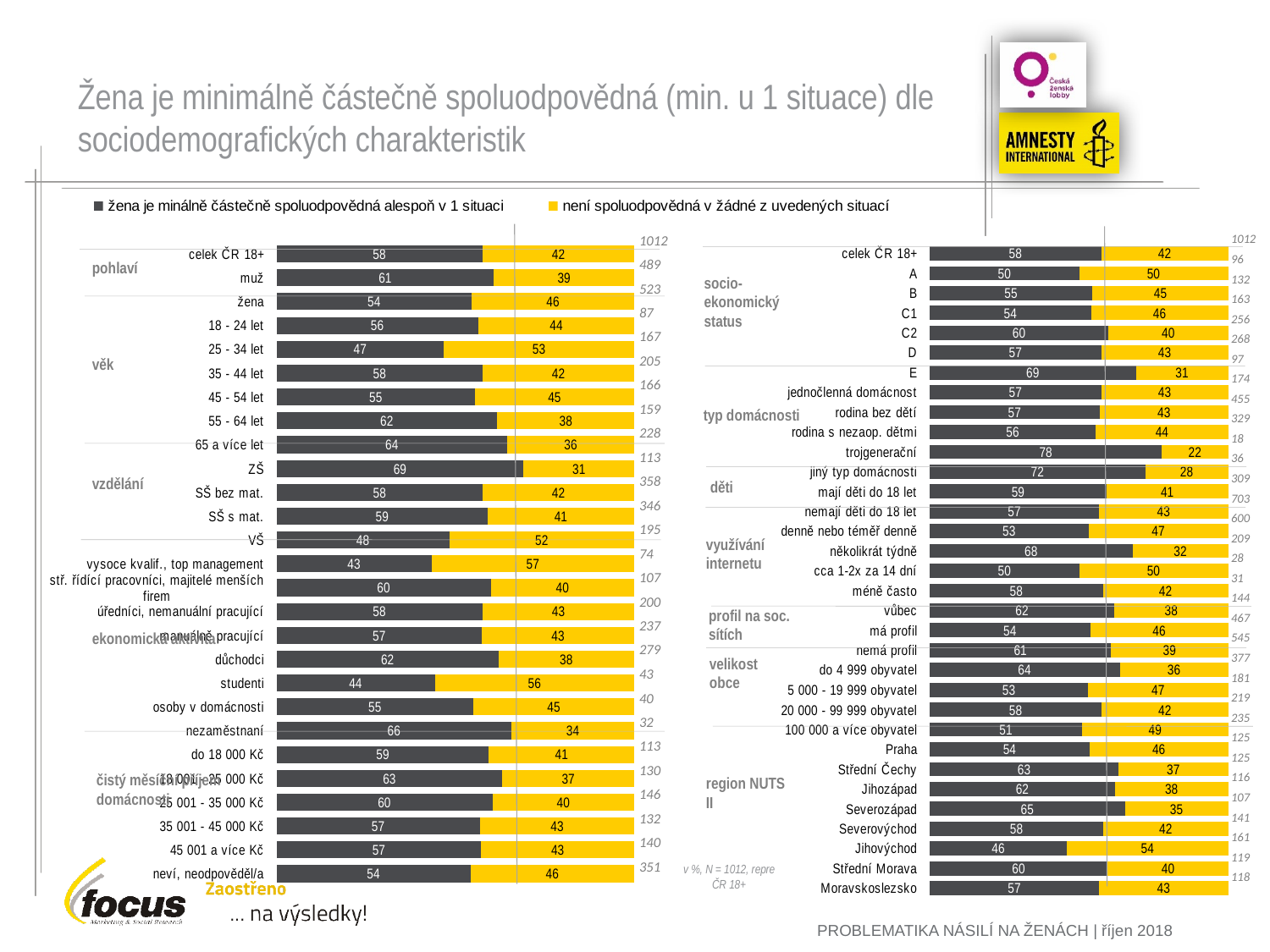
On the left chart, what is the difference between the dark grey values for 'nezaměstnaní' and 'studenti'? 22 On the left chart, what is the value of the yellow series (není spoluodpovědná v žádné z uvedených situací) for '25 - 34 let'? 53 On the right chart, which has a larger dark grey value: 'Severozápad' or 'Praha'? Severozápad On the right chart, what is the total of the stacked bar for 'E'? 100 On the left chart, which category has the lowest dark grey value? vysoce kvalif., top management On the right chart, what is the dark grey value for 'trojgenerační'? 78 On the right chart, which category has the highest dark grey value? trojgenerační What type of chart is shown on the slide? Stacked bar chart How many series does the legend list? 2 On the left chart, what is the value of the dark grey series (žena je minálně částečně spoluodpovědná alespoň v 1 situaci) for 'muž'? 61 On the left chart, which category has the highest dark grey value? ZŠ On the right chart, what is the yellow value for 'Jihovýchod'? 54